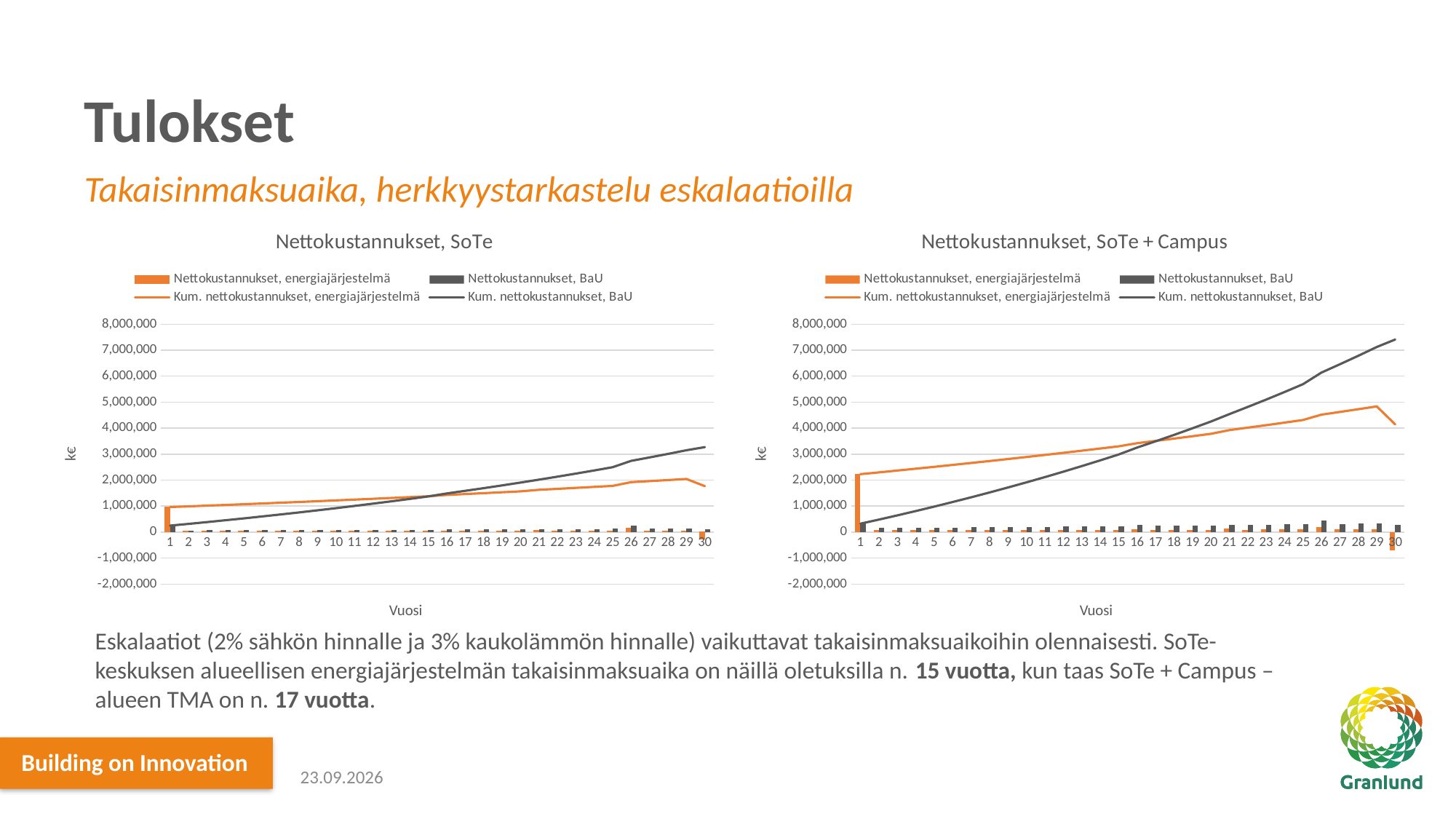
In the chart titled "Nettokustannukset, SoTe + Campus", is the value of "Kum. nettokustannukset, BaU" at year 30 greater or less than 7,000,000? greater What unit is shown on the y axis of the chart titled "Nettokustannukset, SoTe + Campus"? k€ How many years are shown on the x axis of the chart titled "Nettokustannukset, SoTe + Campus"? 30 How many series does the legend of the chart titled "Nettokustannukset, SoTe" list? 4 In the chart titled "Nettokustannukset, SoTe + Campus", does the "Kum. nettokustannukset, BaU" line rise or fall from year 1 to year 30? rise What kind of chart is the chart titled "Nettokustannukset, SoTe"? Combined bar and line chart In the chart titled "Nettokustannukset, SoTe", is the value of "Kum. nettokustannukset, energiajärjestelmä" at year 30 greater or less than 2,000,000? less In the chart titled "Nettokustannukset, SoTe + Campus", is the value of "Kum. nettokustannukset, energiajärjestelmä" at year 1 greater or less than 2,000,000? greater What is the x-axis title of the chart titled "Nettokustannukset, SoTe"? Vuosi In the chart titled "Nettokustannukset, SoTe + Campus", which line is higher at year 30: "Kum. nettokustannukset, BaU" or "Kum. nettokustannukset, energiajärjestelmä"? Kum. nettokustannukset, BaU In the chart titled "Nettokustannukset, SoTe", which line is higher at year 5: "Kum. nettokustannukset, BaU" or "Kum. nettokustannukset, energiajärjestelmä"? Kum. nettokustannukset, energiajärjestelmä